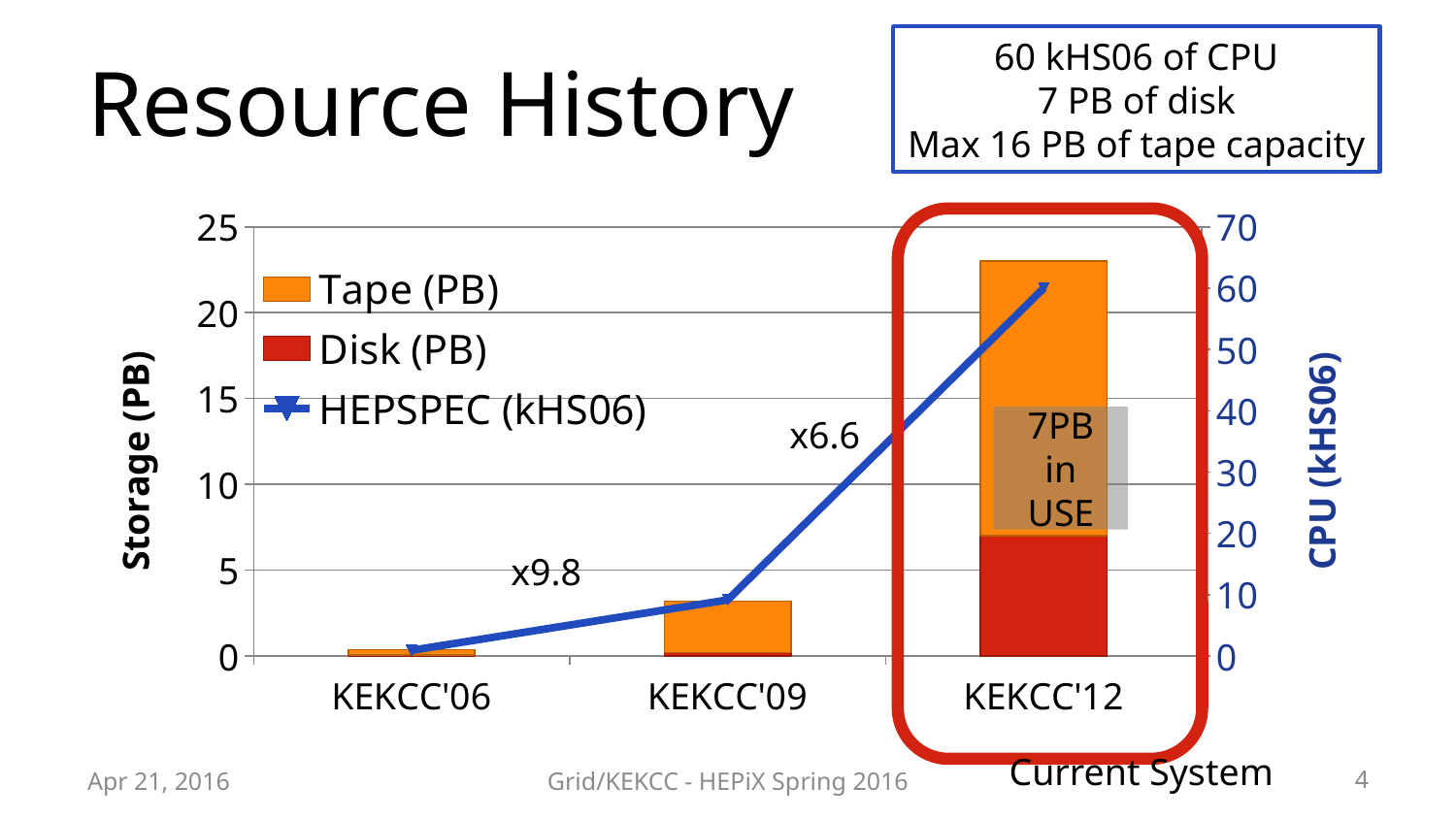
How many series does the chart legend list? 3 Is the total storage for KEKCC'09 greater or less than 5? less Does the HEPSPEC (kHS06) line rise or fall from KEKCC'06 to KEKCC'12? rise How many categories are shown on the x axis? 3 What kind of chart is this? Stacked bar chart with a line series Which category has the lowest HEPSPEC value? KEKCC'06 Is the HEPSPEC value for KEKCC'09 greater or less than 20? less What growth factor is labelled between KEKCC'09 and KEKCC'12? x6.6 Which category has the highest total storage? KEKCC'12 Is the total storage for KEKCC'12 greater or less than 20? greater What is the title of the chart? Resource History What growth factor is labelled between KEKCC'06 and KEKCC'09? x9.8